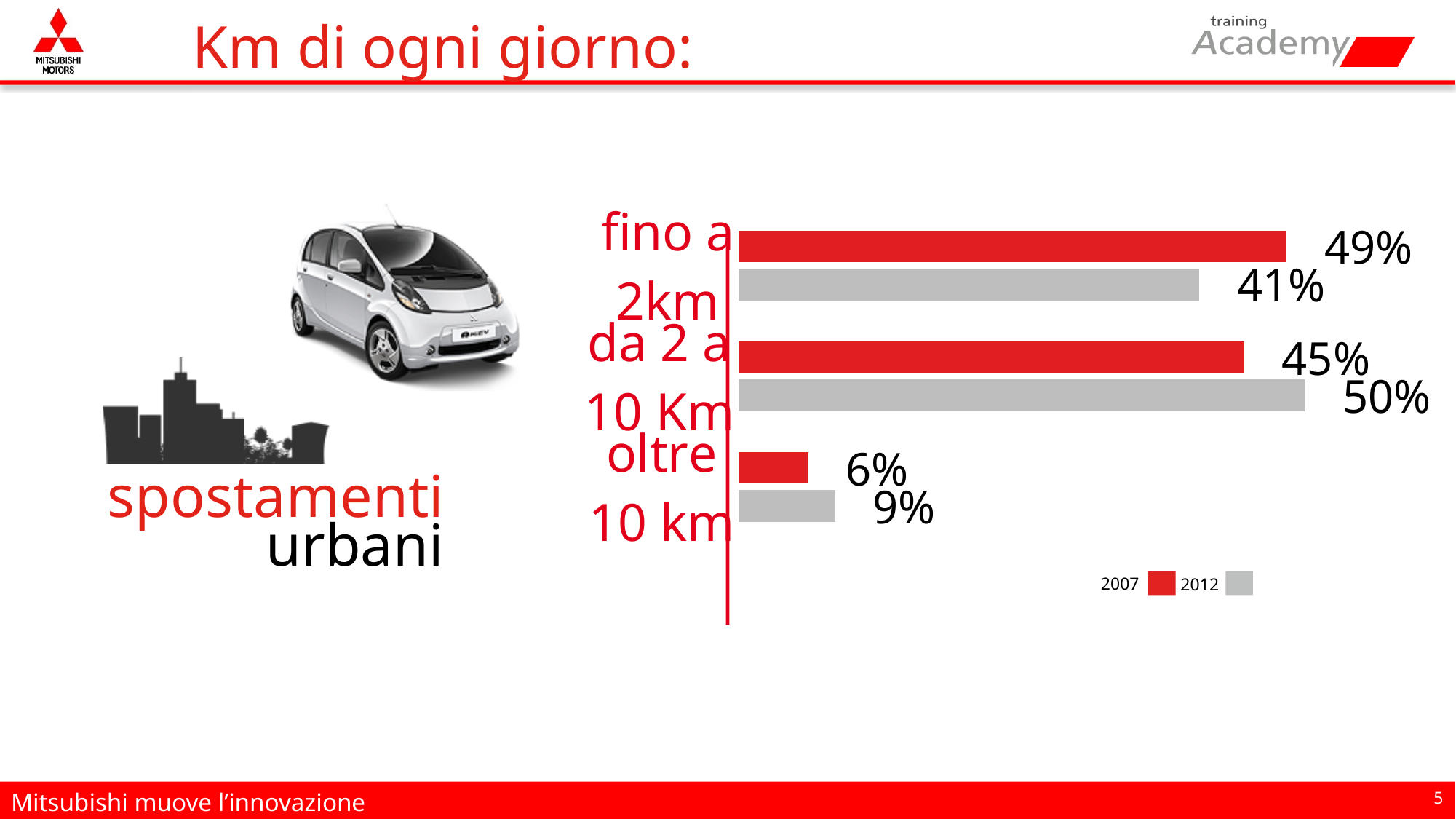
How many categories does the chart show? 3 Which category has the highest 2012 value? da 2 a 10 Km What is the 2012 value for "da 2 a 10 Km"? 50% What is the 2007 value for "fino a 2km"? 49% What kind of chart is shown on the slide? bar chart What is the 2012 value for "oltre 10 km"? 9% For "oltre 10 km", which is larger: the 2007 value or the 2012 value? 2012 How many series does the legend list? 2 What is the 2007 value for "da 2 a 10 Km"? 45% Which category has the lowest 2007 value? oltre 10 km What is the difference between the 2007 and 2012 values for "fino a 2km"? 8% What is the 2012 value for "fino a 2km"? 41%